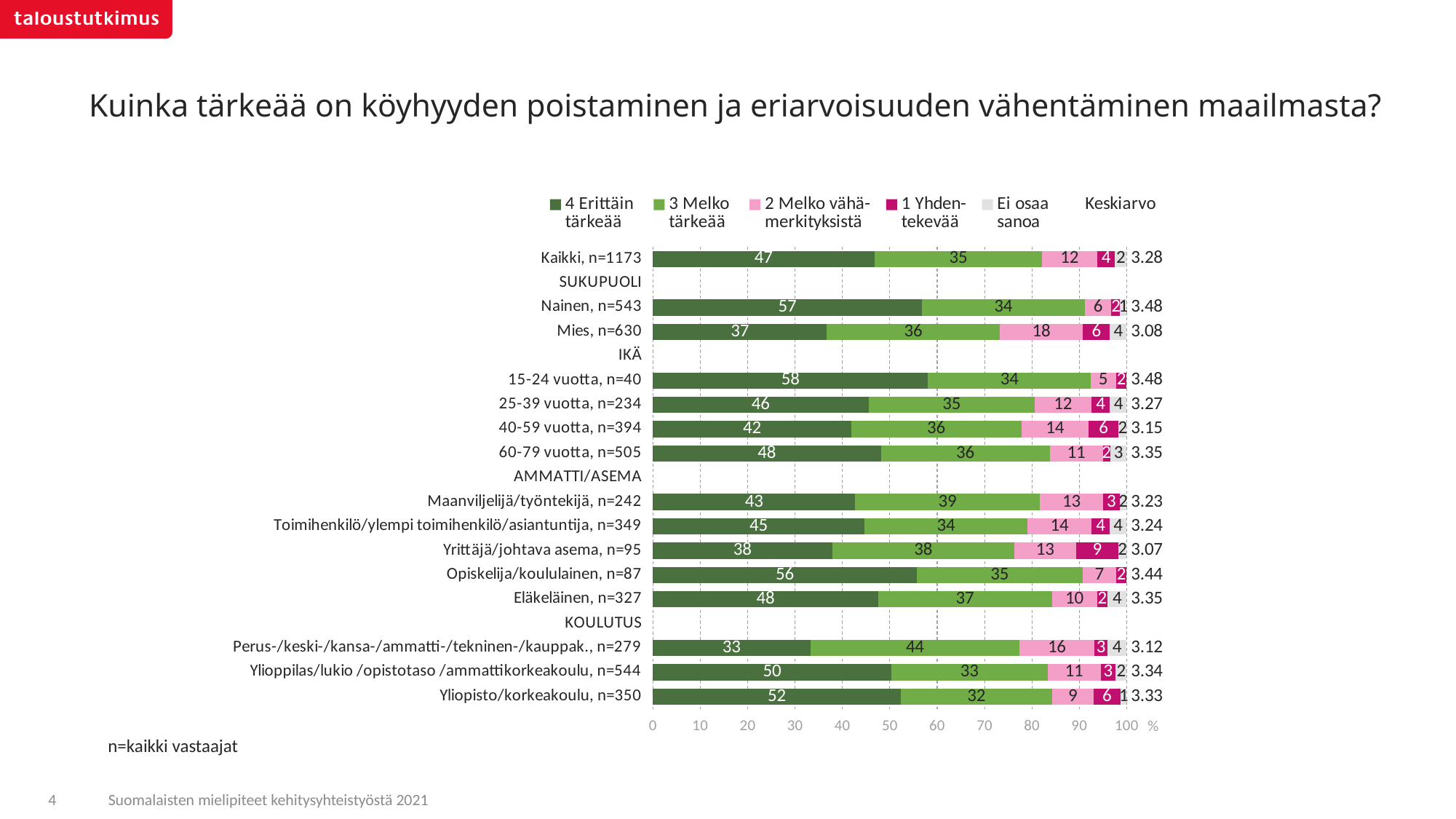
How many response categories does the legend list, excluding Keskiarvo? 5 What percentage of Kaikki, n=1173 answered 4 Erittäin tärkeää? 47 Which group has the highest share of 4 Erittäin tärkeää? 15-24 vuotta, n=40 What is the Keskiarvo value for Mies, n=630? 3.08 Which group has the lowest Keskiarvo? Yrittäjä/johtava asema, n=95 What type of chart is shown on the slide? Stacked bar chart Is the 4 Erittäin tärkeää value for Perus-/keski-/kansa-/ammatti-/tekninen-/kauppak., n=279 greater or less than 40? less How many respondent groups (bars) are plotted in the chart? 15 Which has a larger share of 2 Melko vähämerkityksistä: Mies, n=630 or Nainen, n=543? Mies, n=630 What is the difference in the 4 Erittäin tärkeää share between Nainen, n=543 and Mies, n=630? 20 What percentage of Yrittäjä/johtava asema, n=95 answered 1 Yhdentekevää? 9 What is the Keskiarvo value for Opiskelija/koululainen, n=87? 3.44